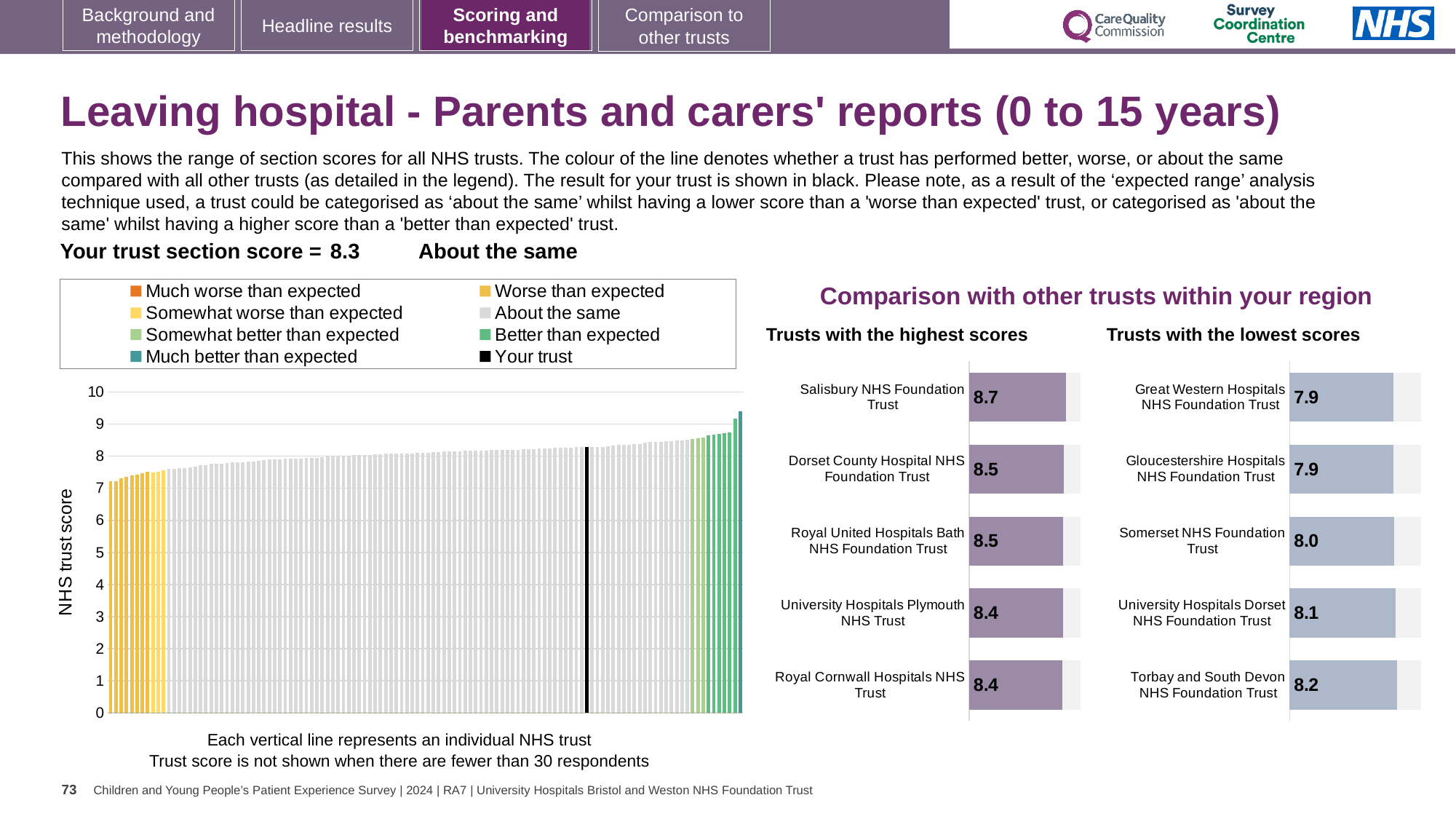
In the 'Trusts with the highest scores' chart, what is the score for Salisbury NHS Foundation Trust? 8.7 In the 'Trusts with the lowest scores' chart, what is the score for Somerset NHS Foundation Trust? 8.0 How many trusts are listed in the 'Trusts with the highest scores' chart? 5 In the main chart on the left, is the value of the lowest (leftmost) trust greater or less than 8? less How many entries does the legend of the main chart on the left list? 8 Which is larger: the score for Salisbury NHS Foundation Trust in the highest scores chart or the score for Great Western Hospitals NHS Foundation Trust in the lowest scores chart? Salisbury NHS Foundation Trust In the main chart on the left, do the trust scores rise or fall from left to right? rise In the 'Trusts with the highest scores' chart, what is the difference between the scores of Salisbury NHS Foundation Trust and Royal Cornwall Hospitals NHS Trust? 0.3 In the 'Trusts with the lowest scores' chart, which trust has the highest score shown? Torbay and South Devon NHS Foundation Trust In the 'Trusts with the lowest scores' chart, what is the difference between the scores of Torbay and South Devon NHS Foundation Trust and Great Western Hospitals NHS Foundation Trust? 0.3 In the main chart on the left, what is the section score for your trust (the black line)? 8.3 In the 'Trusts with the highest scores' chart, which trust has the highest score? Salisbury NHS Foundation Trust